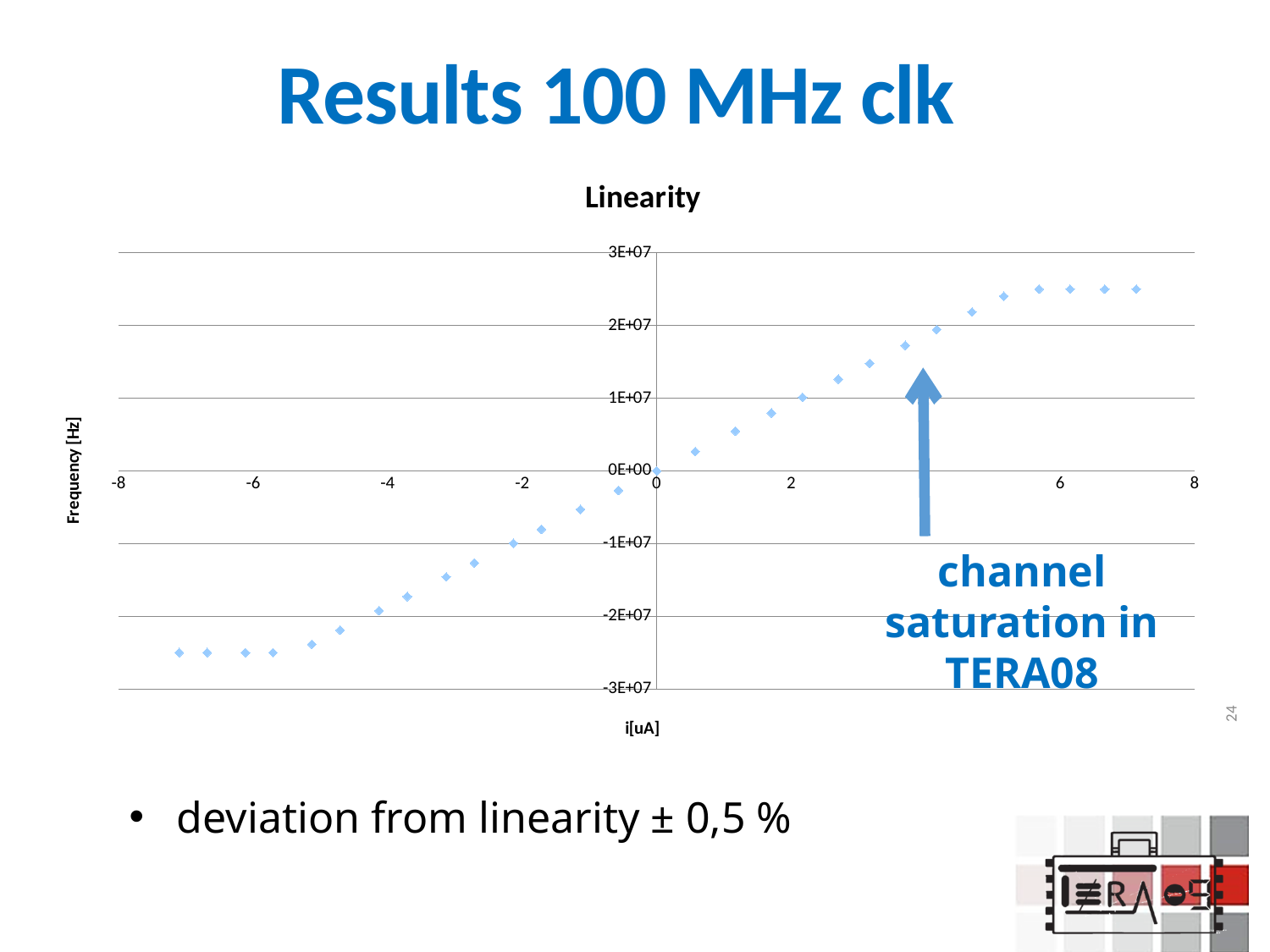
Do the plotted frequency values rise or fall as i[uA] increases along the x axis? rise Is the frequency value at i = -6 uA greater or less than -2E+07? less What is the label of the y axis of the chart? Frequency [Hz] What kind of chart is shown on the slide? scatter chart Is the frequency value at i = 7 uA greater or less than 3E+07? less Which has the larger frequency value: the point at i = 6 uA or the point at i = 2 uA? i = 6 uA Which has the lower frequency value: the point at i = -6 uA or the point at i = -2 uA? i = -6 uA Is the frequency value at i = -4 uA greater or less than -1E+07? less What is the title of the chart? Linearity